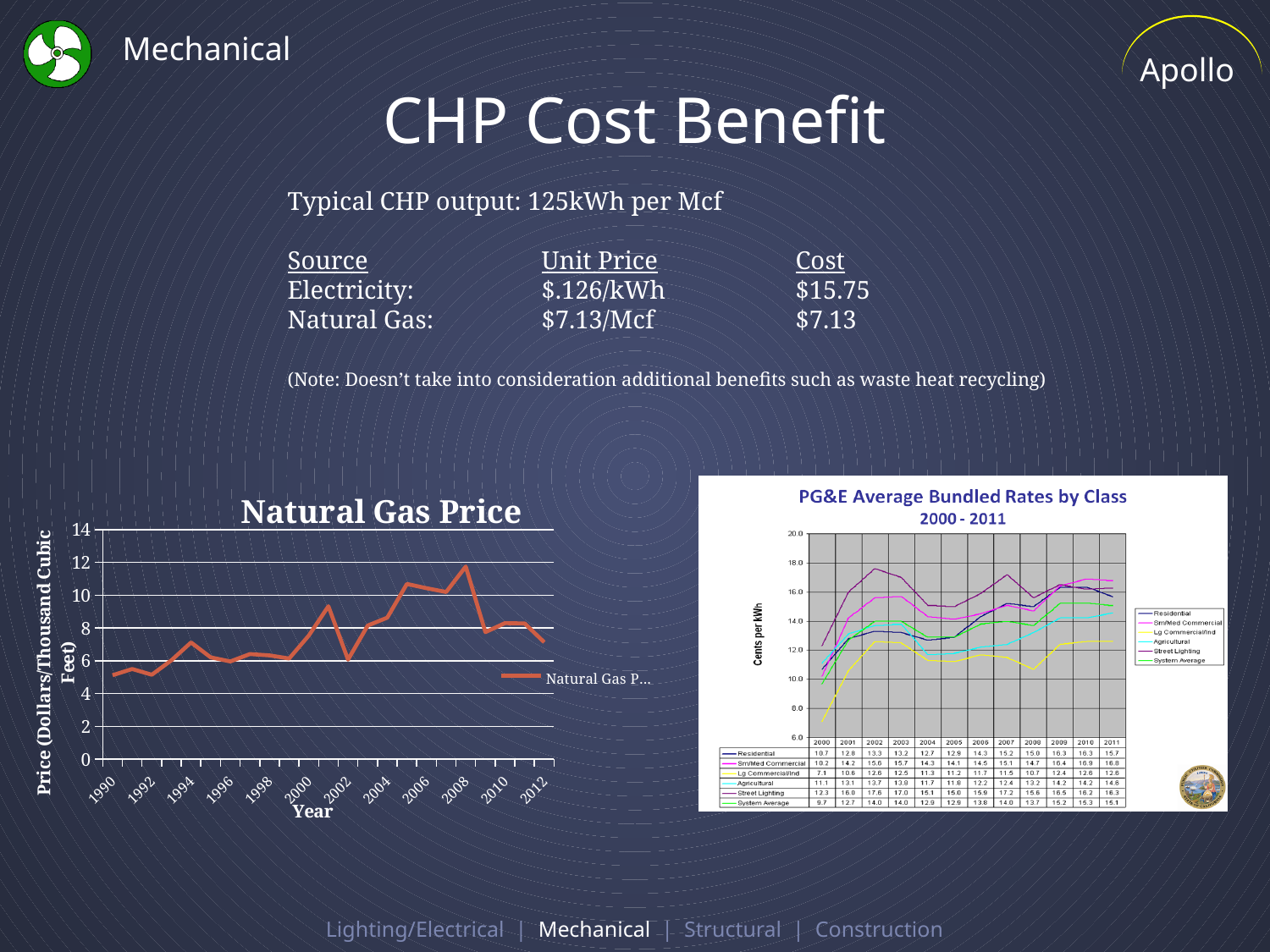
In the Natural Gas Price chart, in which year does the natural gas price reach its highest point? 2008 In the PG&E Average Bundled Rates by Class chart, what is the Residential rate in 2000? 10.7 How many years are plotted in the PG&E Average Bundled Rates by Class chart? 12 What is the y-axis label of the Natural Gas Price chart? Price (Dollars/Thousand Cubic Feet) What type of chart is the Natural Gas Price chart? line chart How many series does the legend of the PG&E Average Bundled Rates by Class chart list? 6 In the PG&E Average Bundled Rates by Class chart, what is the System Average rate in 2011? 15.1 In the PG&E Average Bundled Rates by Class chart, what is the Lg Commercial/Ind rate in 2000? 7.1 In the Natural Gas Price chart, is the natural gas price higher in 2008 or in 2012? 2008 In the PG&E Average Bundled Rates by Class chart, what is the difference between the Residential rate in 2011 and in 2000? 5.0 In the Natural Gas Price chart, is the value for 2008 greater or less than 10? greater In the Natural Gas Price chart, is the value for 1990 greater or less than 6? less